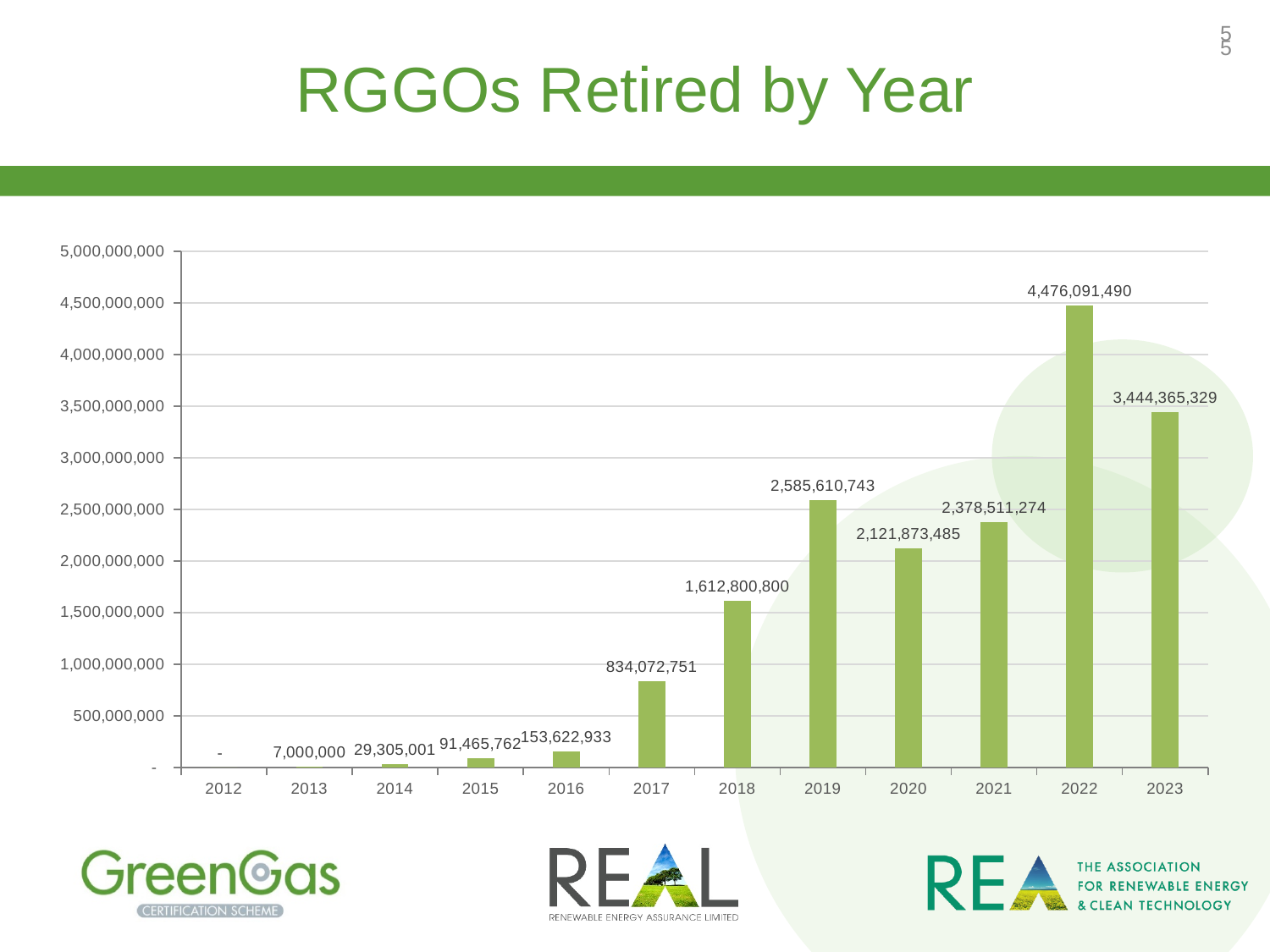
Which is larger, the value for 2019 or the value for 2021? 2019 Which year has the highest value? 2022 What is the difference between the values for 2022 and 2023? 1,031,726,161 What is the value for 2018? 1,612,800,800 What is the difference between the values for 2019 and 2020? 463,737,258 What kind of chart is this? Bar chart How many years are shown on the x axis? 12 Which year has the lowest value? 2012 What is the value for 2013? 7,000,000 What is the title of the chart? RGGOs Retired by Year What is the value for 2022? 4,476,091,490 What is the value for 2023? 3,444,365,329